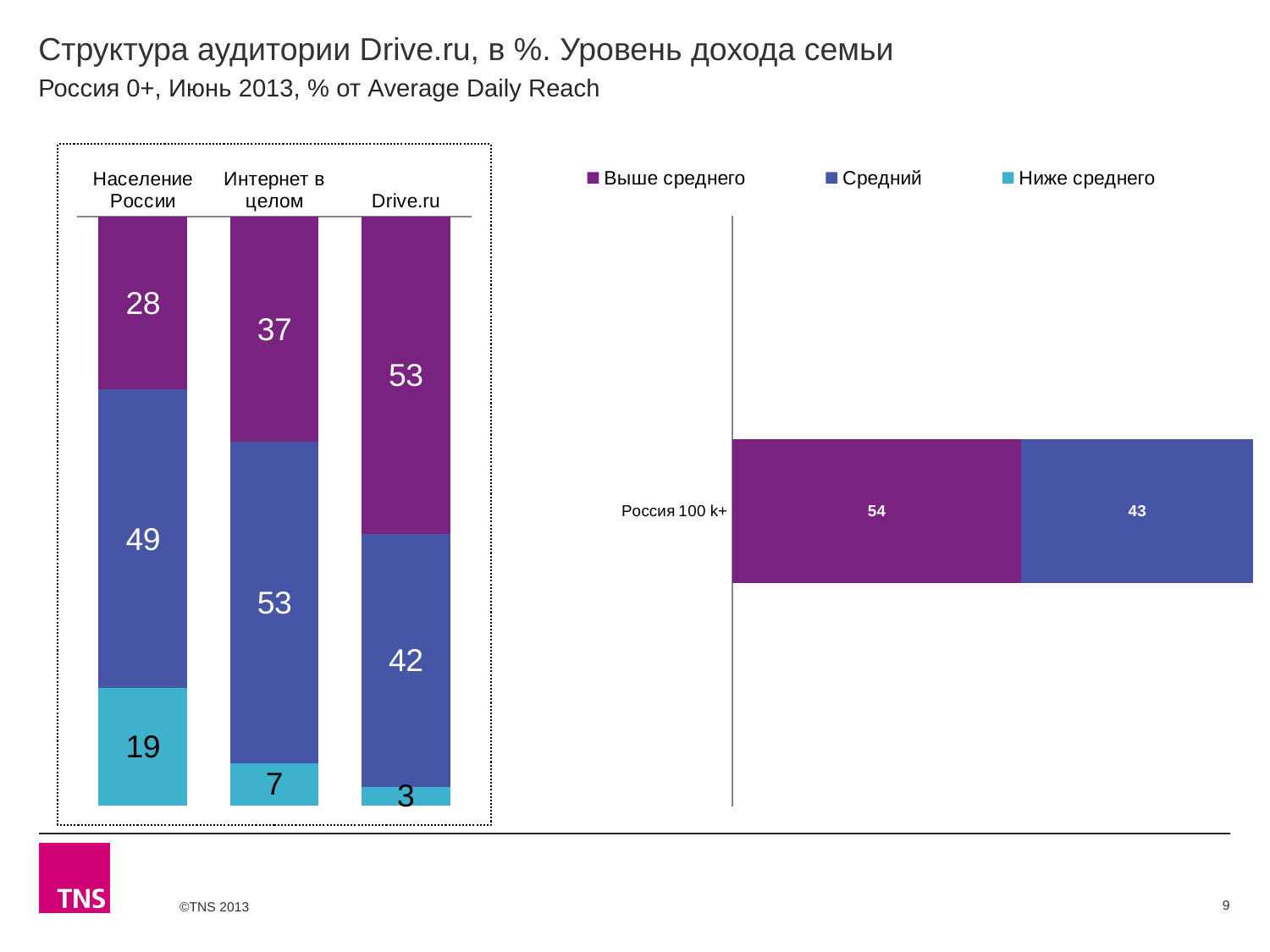
In the left chart, what is the value for Ниже среднего for Население России? 19 In the left chart, which category has the lowest value for Ниже среднего? Drive.ru In the left chart, which category has the highest value for Выше среднего? Drive.ru In the right chart, what is the difference between the Выше среднего and Средний values for Россия 100 k+? 11 In the left chart, what is the value for Средний for Drive.ru? 42 What kind of chart is the left chart? Stacked bar chart In the right chart, what is the value for Выше среднего for Россия 100 k+? 54 In the left chart, what is the value for Выше среднего for Интернет в целом? 37 In the left chart, how many categories are shown? 3 In the left chart, what is the difference between the Выше среднего values for Drive.ru and Население России? 25 How many series does the legend list? 3 In the left chart, is the Средний value larger for Население России or for Интернет в целом? Интернет в целом